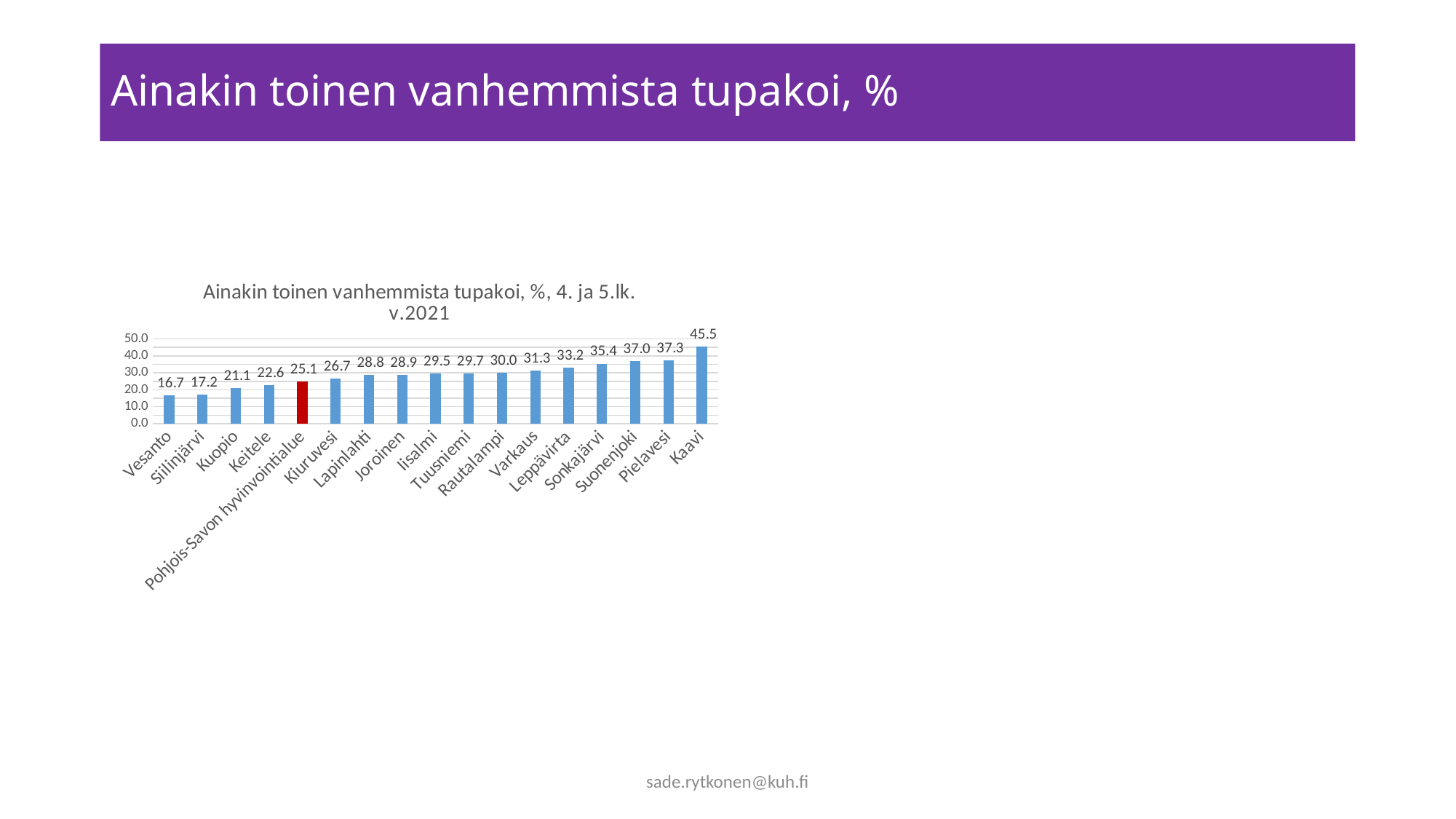
What is the value for Pohjois-Savon hyvinvointialue? 25.1 Is the value for Pielavesi greater or less than 30.0? greater Which is larger, the value for Suonenjoki or the value for Leppävirta? Suonenjoki What kind of chart is shown? bar chart What is the difference between the values for Kaavi and Vesanto? 28.8 What is the value for Varkaus? 31.3 What is the value for Kuopio? 21.1 Which category has the highest value? Kaavi Which category has the lowest value? Vesanto Which category's bar is coloured red instead of blue? Pohjois-Savon hyvinvointialue How many categories are shown on the x axis? 17 Do the values rise or fall from left to right along the x axis? rise